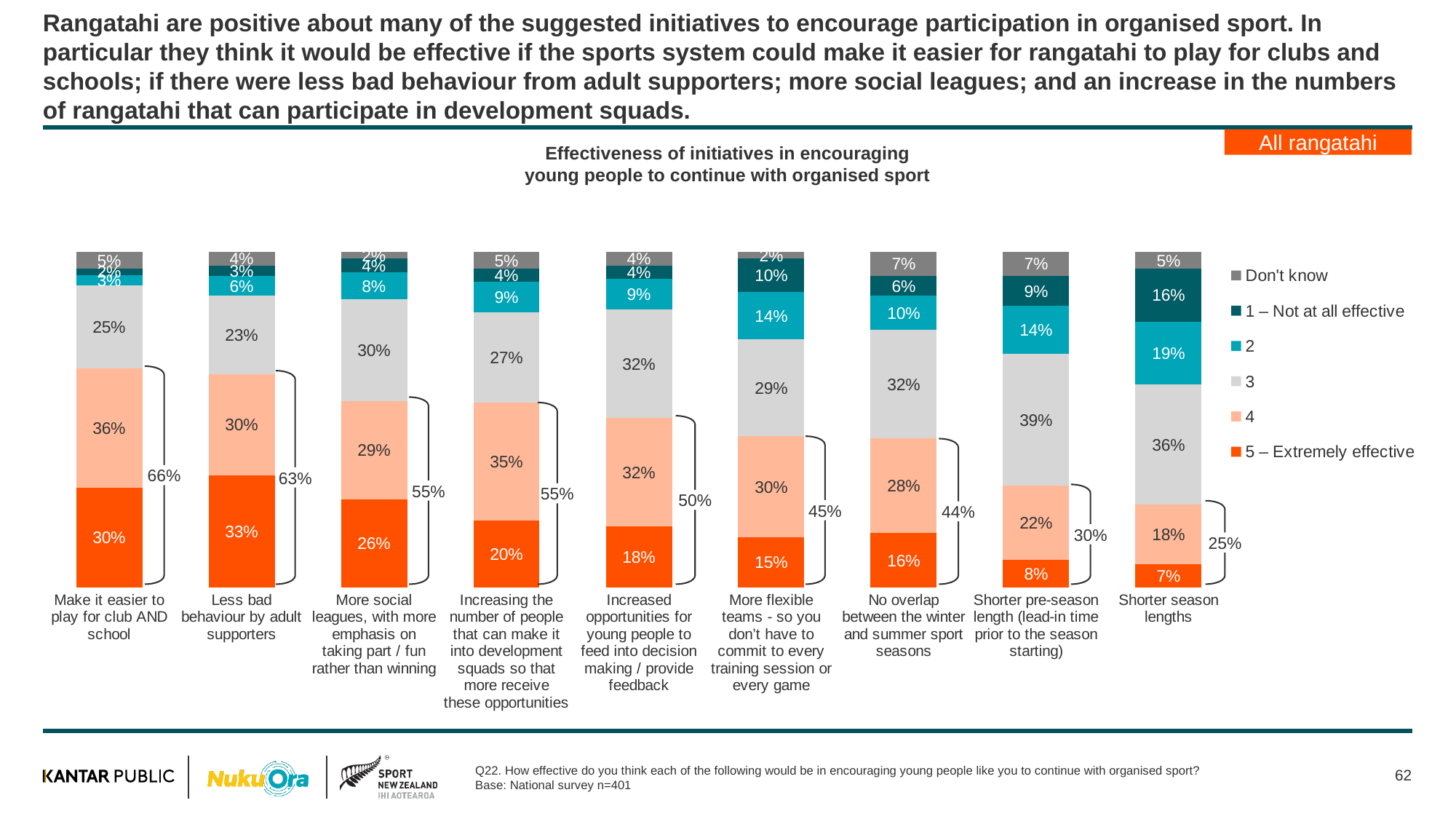
Which initiative has the lowest percentage rating it 5 – Extremely effective? Shorter season lengths What is the title of the chart? Effectiveness of initiatives in encouraging young people to continue with organised sport How many initiatives are shown on the chart? 9 Which initiative has the highest percentage rating it 5 – Extremely effective? Less bad behaviour by adult supporters What percentage rated 'Shorter season lengths' as 1 – Not at all effective? 16% What is the combined percentage (bracket label) for ratings 4 and 5 for 'Make it easier to play for club AND school'? 66% What is the difference between the 5 – Extremely effective percentages for 'Make it easier to play for club AND school' and 'Shorter pre-season length'? 22% What percentage rated 'More flexible teams' as 2? 14% Which has a larger percentage rating it 3: 'Shorter pre-season length' or 'More social leagues'? Shorter pre-season length How many series does the legend list? 6 What percentage of rangatahi rated 'Less bad behaviour by adult supporters' as 5 – Extremely effective? 33% What type of chart is shown? Stacked bar chart